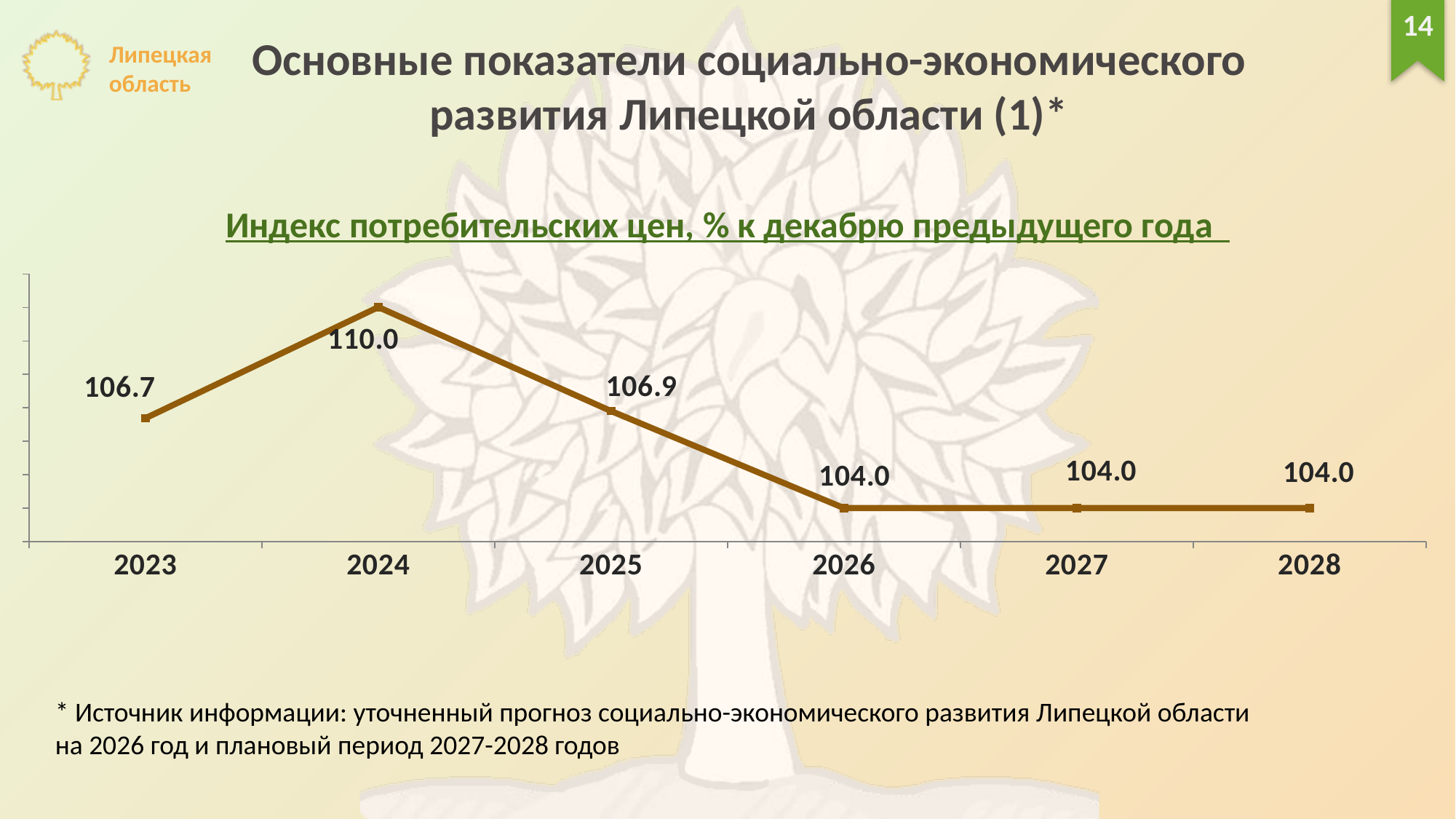
What is the consumer price index value for 2027? 104.0 How many years are plotted on the chart? 6 What is the difference between the 2023 value and the 2026 value? 2.7 What is the consumer price index value for 2024? 110.0 What is the consumer price index value for 2025? 106.9 What kind of chart is shown on the slide? Line chart What is the difference between the 2024 value and the 2025 value? 3.1 What is the consumer price index value for 2023? 106.7 What is the title of the chart? Индекс потребительских цен, % к декабрю предыдущего года Which year has the highest consumer price index value? 2024 Do the values rise or fall from 2024 to 2026? Fall Which is larger, the value for 2023 or the value for 2025? 2025